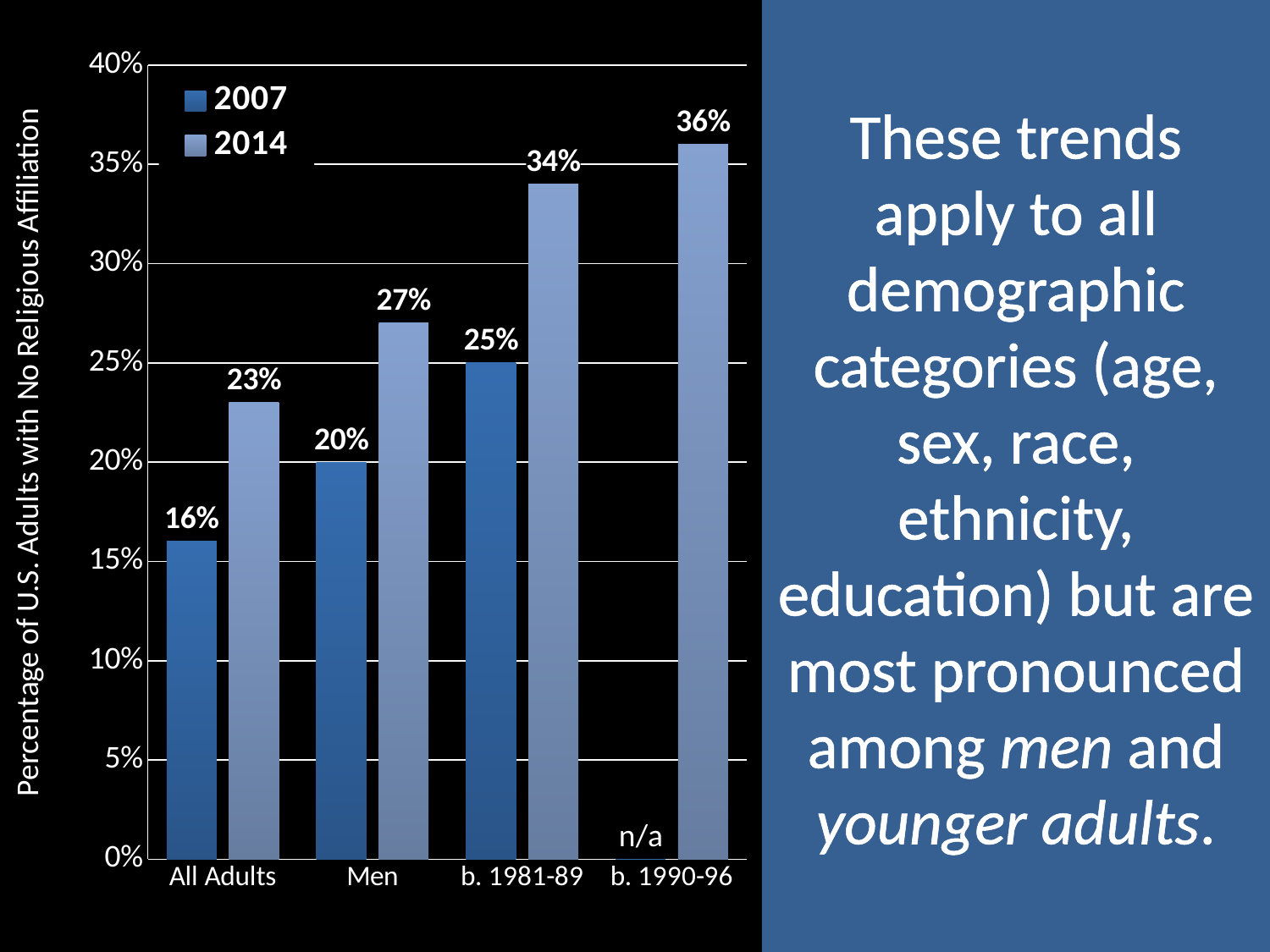
Which is larger, the 2014 value for All Adults or the 2007 value for Men? 2014 value for All Adults What is the 2014 value for b. 1981-89? 34% How many series does the legend list? 2 What is the difference between the 2014 and 2007 values for b. 1981-89? 9% How many categories are shown on the x axis? 4 Which category has the highest 2014 value? b. 1990-96 Which category has the lowest 2007 value? All Adults What is the 2007 value for b. 1990-96? n/a What kind of chart is shown on the slide? Bar chart What is the label of the vertical axis? Percentage of U.S. Adults with No Religious Affiliation What is the 2014 value for Men? 27% What is the 2007 value for All Adults? 16%